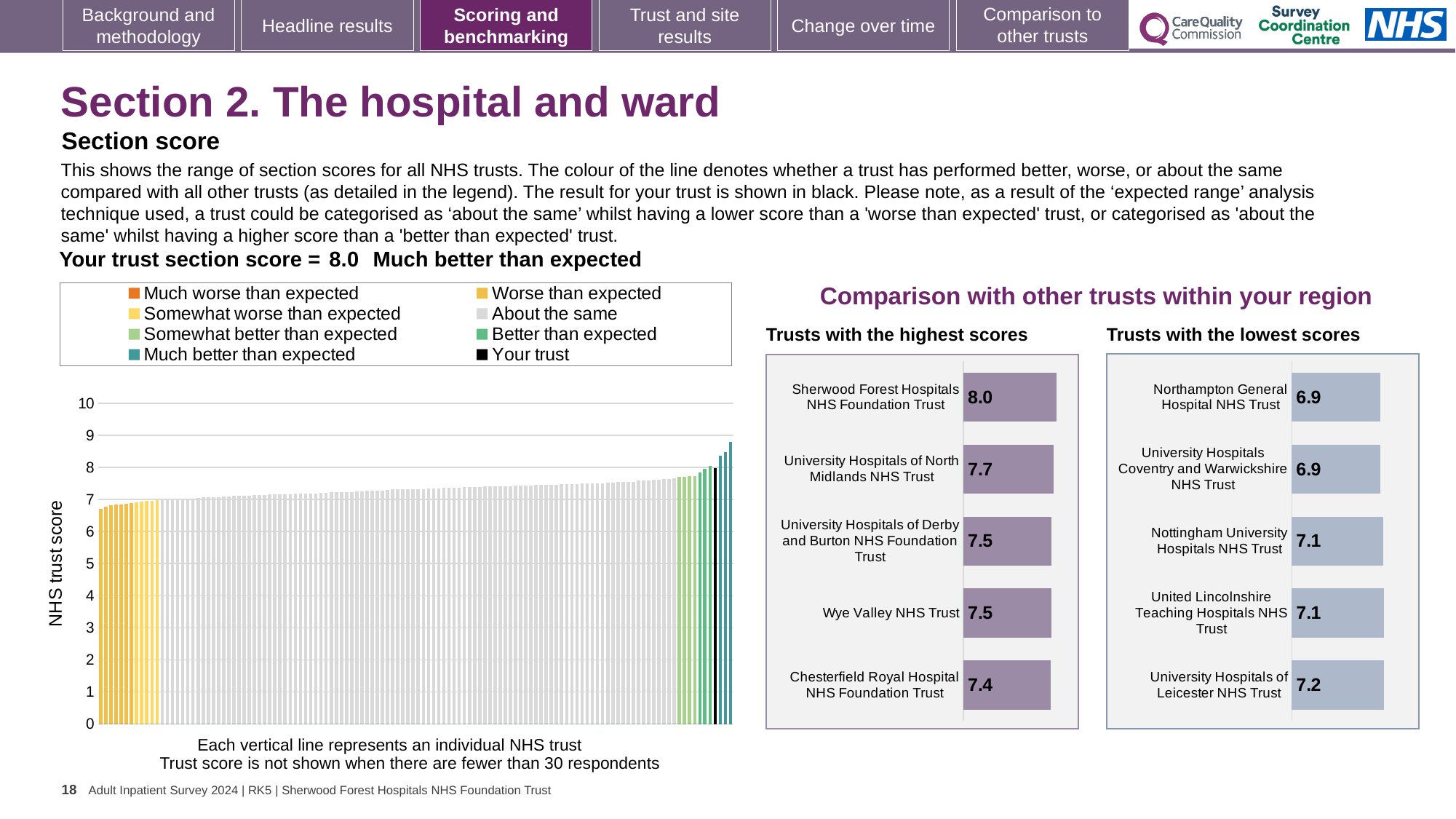
In the 'Trusts with the highest scores' chart, what is the score for Sherwood Forest Hospitals NHS Foundation Trust? 8.0 In the 'Trusts with the lowest scores' chart, what is the difference between the scores of University Hospitals of Leicester NHS Trust and Northampton General Hospital NHS Trust? 0.3 What kind of chart is the large chart on the left showing NHS trust scores? Bar chart How many entries does the legend of the large chart on the left list? 8 In the 'Trusts with the highest scores' chart, what is the difference between the scores of Sherwood Forest Hospitals NHS Foundation Trust and Chesterfield Royal Hospital NHS Foundation Trust? 0.6 In the 'Trusts with the lowest scores' chart, which has the larger score: Northampton General Hospital NHS Trust or University Hospitals of Leicester NHS Trust? University Hospitals of Leicester NHS Trust In the 'Trusts with the highest scores' chart, which trust has the lowest score? Chesterfield Royal Hospital NHS Foundation Trust In the 'Trusts with the highest scores' chart, what is the score for University Hospitals of North Midlands NHS Trust? 7.7 In the large chart on the left, do the trust scores rise or fall from left to right? Rise In the 'Trusts with the lowest scores' chart, which trust has the highest score? University Hospitals of Leicester NHS Trust How many trusts are shown in the 'Trusts with the highest scores' chart? 5 In the 'Trusts with the lowest scores' chart, what is the score for Nottingham University Hospitals NHS Trust? 7.1